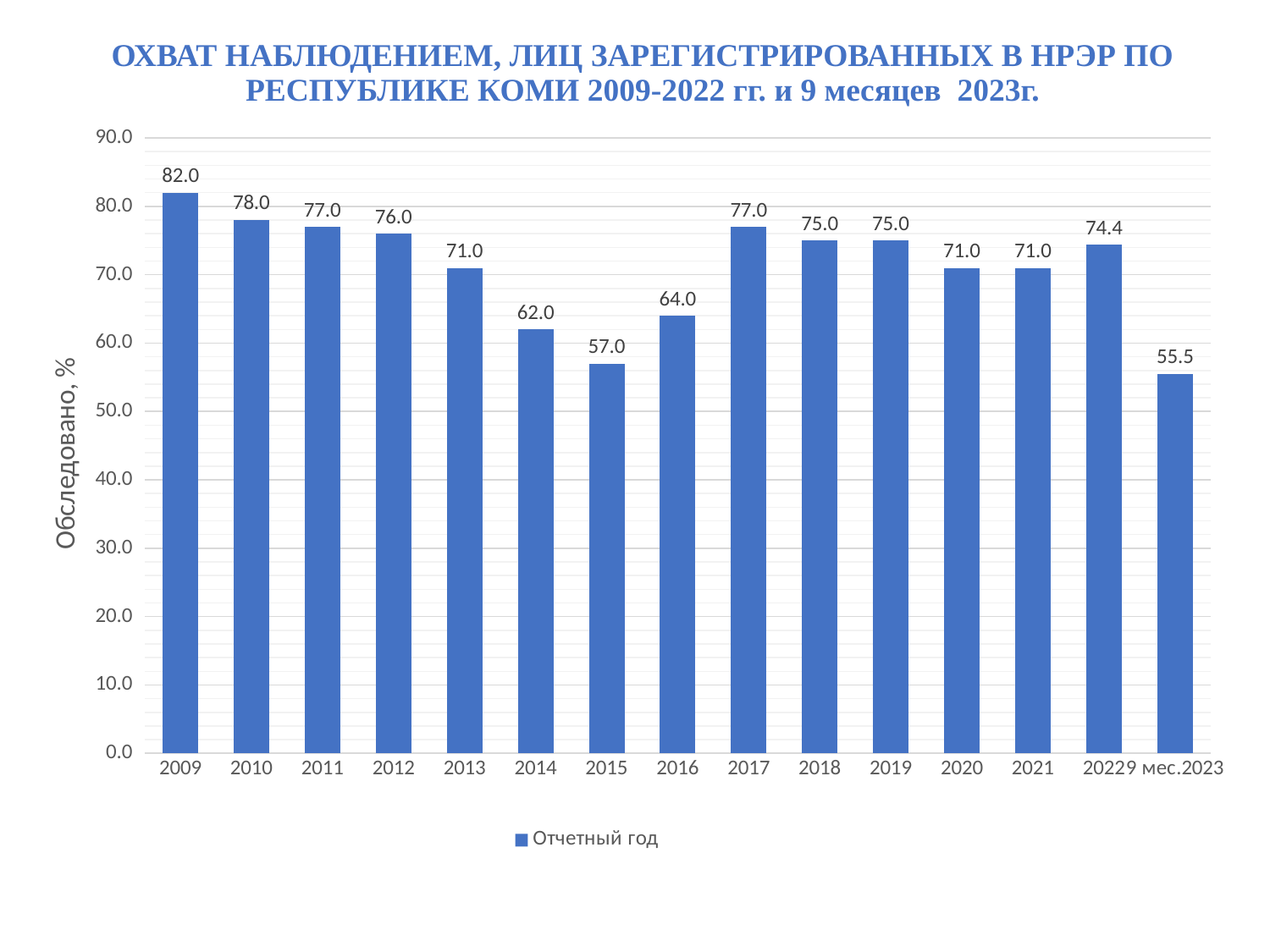
Which is larger, the value for 2014 or the value for 2016? 2016 Is the value for 2013 greater or less than 70.0? greater What kind of chart is this? bar chart What is the value for 2015? 57.0 How many categories are shown on the x axis? 15 What is the value for 2022? 74.4 Which category has the lowest value? 9 мес.2023 Which category has the highest value? 2009 What is the difference between the values for 2009 and 2015? 25.0 What is the value for 9 мес.2023? 55.5 What is the legend entry for the series? Отчетный год What is the value for 2009? 82.0